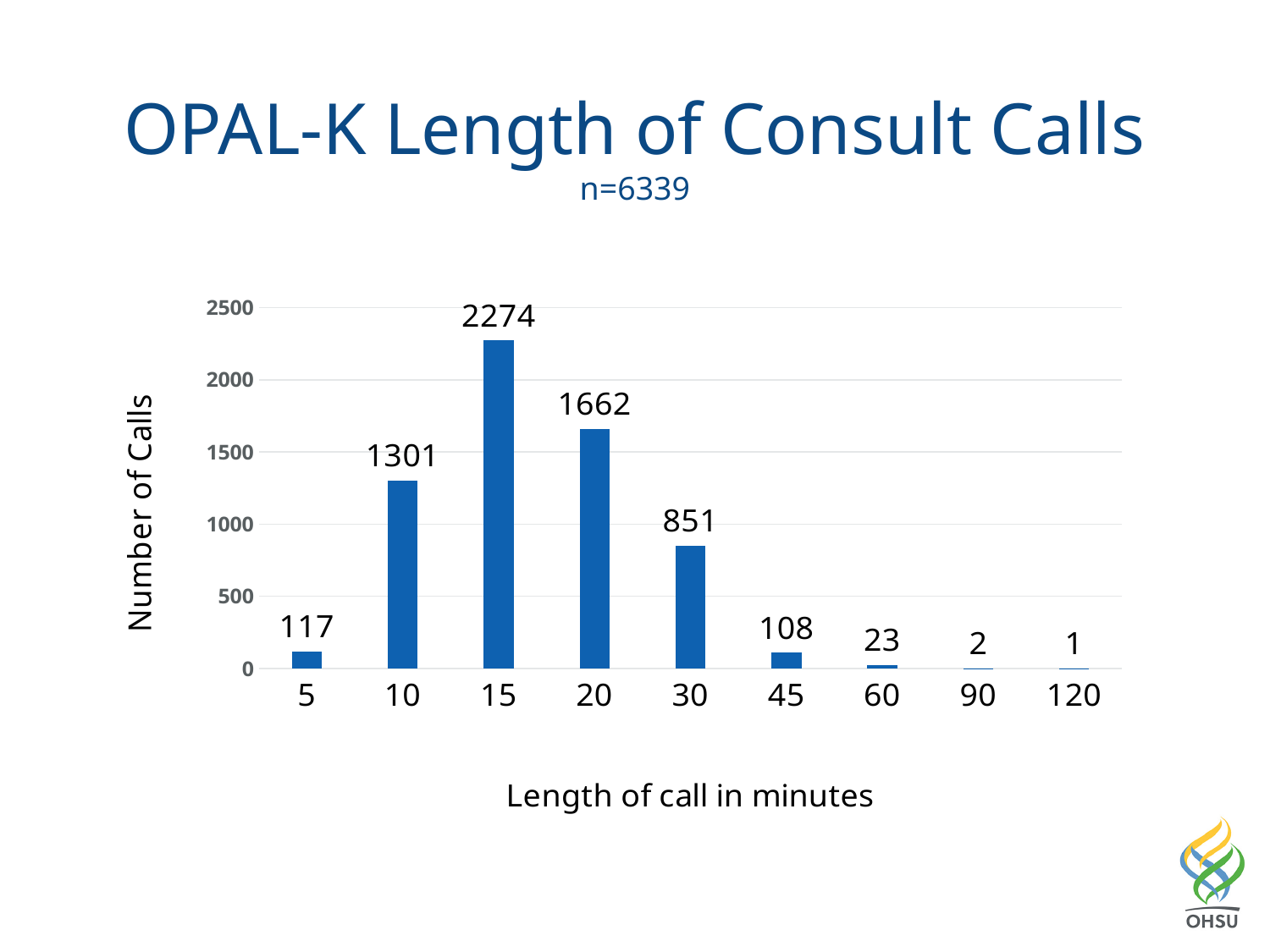
How many call length categories are shown on the x axis? 9 Which call length has the highest number of calls? 15 What is the label of the x axis? Length of call in minutes What is the difference in number of calls between the 15-minute and 20-minute call lengths? 612 What is the difference in number of calls between the 10-minute and 5-minute call lengths? 1184 What is the number of calls for the 30-minute call length? 851 How many calls lasted 60 minutes? 23 How many calls lasted 15 minutes? 2274 Is the number of calls for the 20-minute call length greater or less than 1500? greater Which call length has the lowest number of calls? 120 What type of chart is shown on the slide? bar chart Which has more calls, the 5-minute or the 45-minute call length? 5